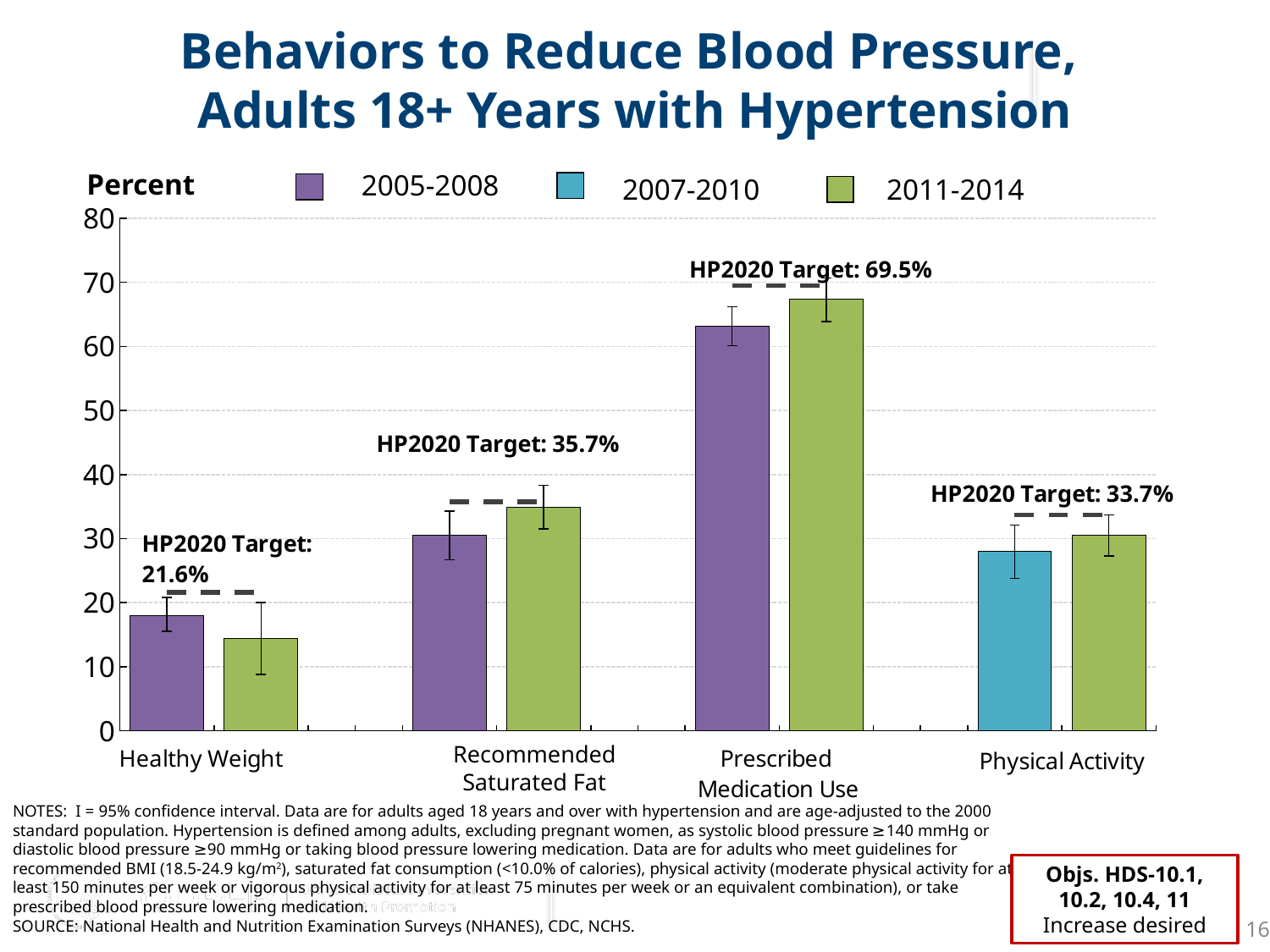
Is the 2011-2014 value for Prescribed Medication Use greater or less than 60? greater Which behavior category has the lowest bars? Healthy Weight For Prescribed Medication Use, which is larger: the 2005-2008 value or the 2011-2014 value? 2011-2014 Which behavior category has the highest bars? Prescribed Medication Use Is the 2007-2010 value for Physical Activity greater or less than 30? less What is the HP2020 Target shown for Healthy Weight? 21.6% What is the HP2020 Target shown for Prescribed Medication Use? 69.5% Which legend entry is shown in green? 2011-2014 How many series does the legend list? 3 Is the 2011-2014 value for Healthy Weight greater or less than 20? less How many behavior categories are shown on the x axis? 4 What kind of chart is shown on the slide? bar chart